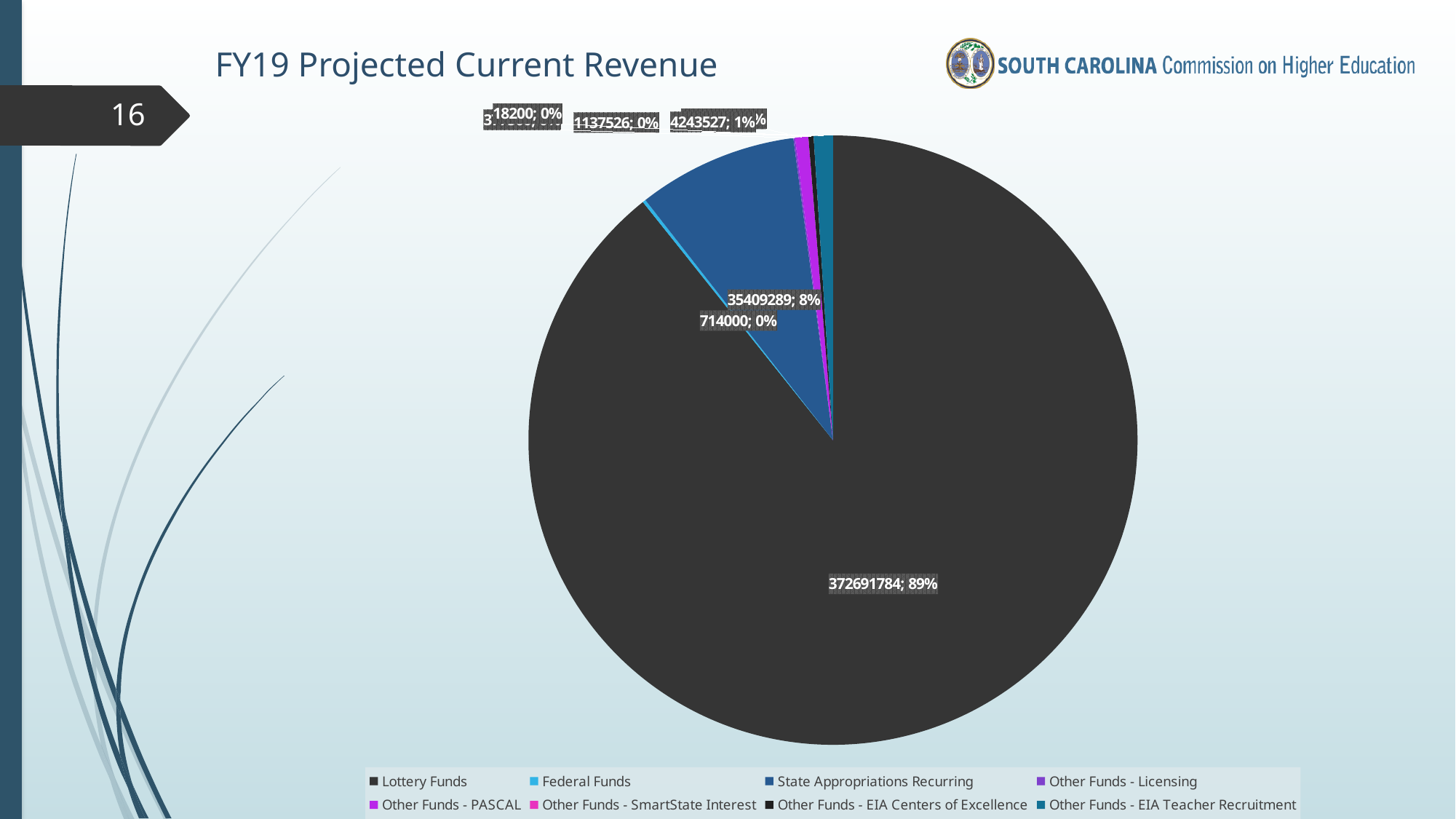
What share of the pie does Lottery Funds represent? 89% What is the value shown for Lottery Funds? 372691784 What is the value shown for Federal Funds? 714000 How many categories does the legend list? 8 Which legend entry is shown in dark gray? Lottery Funds What is the title of the chart? FY19 Projected Current Revenue What share of the pie does State Appropriations Recurring represent? 8% Which is larger, Lottery Funds or State Appropriations Recurring? Lottery Funds What is the value shown for State Appropriations Recurring? 35409289 Which category has the largest slice of the pie? Lottery Funds What is the difference between the Lottery Funds value and the State Appropriations Recurring value? 337282495 What kind of chart is shown on the slide? pie chart